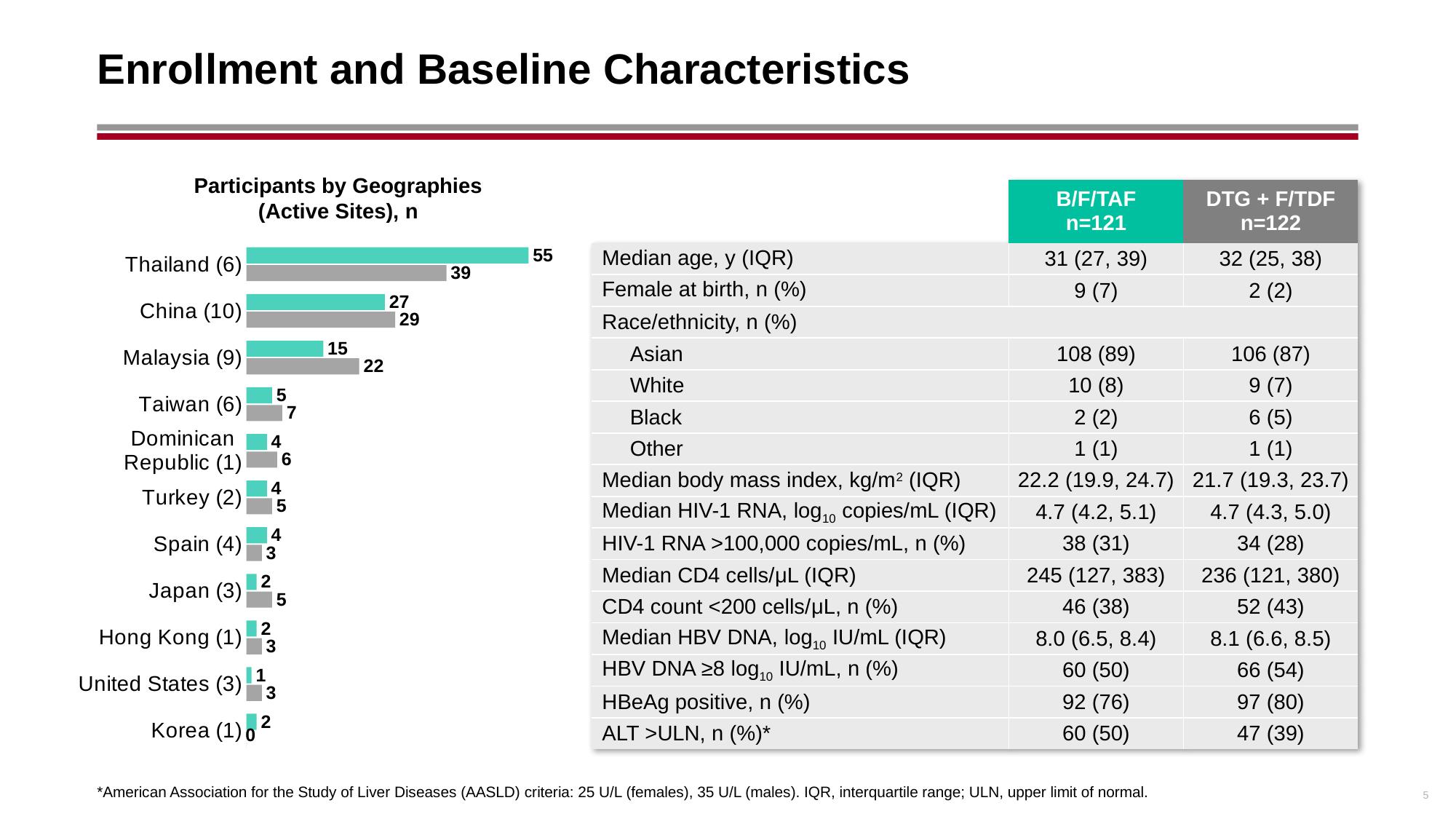
In the 'Participants by Geographies' chart, which is larger for Spain (4): the teal bar or the gray bar? the teal bar In the 'Participants by Geographies' chart, which is larger for China (10): the teal bar or the gray bar? the gray bar What kind of chart is 'Participants by Geographies (Active Sites), n'? bar chart In the 'Participants by Geographies' chart, what is the difference between the teal and gray bar values for Thailand (6)? 16 In the 'Participants by Geographies' chart, what is the value of the gray bar for Malaysia (9)? 22 In the 'Participants by Geographies' chart, what is the difference between the gray and teal bar values for Malaysia (9)? 7 In the 'Participants by Geographies' chart, what is the value of the gray bar for Korea (1)? 0 What is the title of the bar chart on the slide? Participants by Geographies (Active Sites), n How many geographies are shown in the 'Participants by Geographies' chart? 11 In the 'Participants by Geographies' chart, which geography has the lowest gray bar value? Korea (1) In the 'Participants by Geographies' chart, which geography has the highest teal bar value? Thailand (6) In the 'Participants by Geographies' chart, what is the value of the teal bar for Thailand (6)? 55